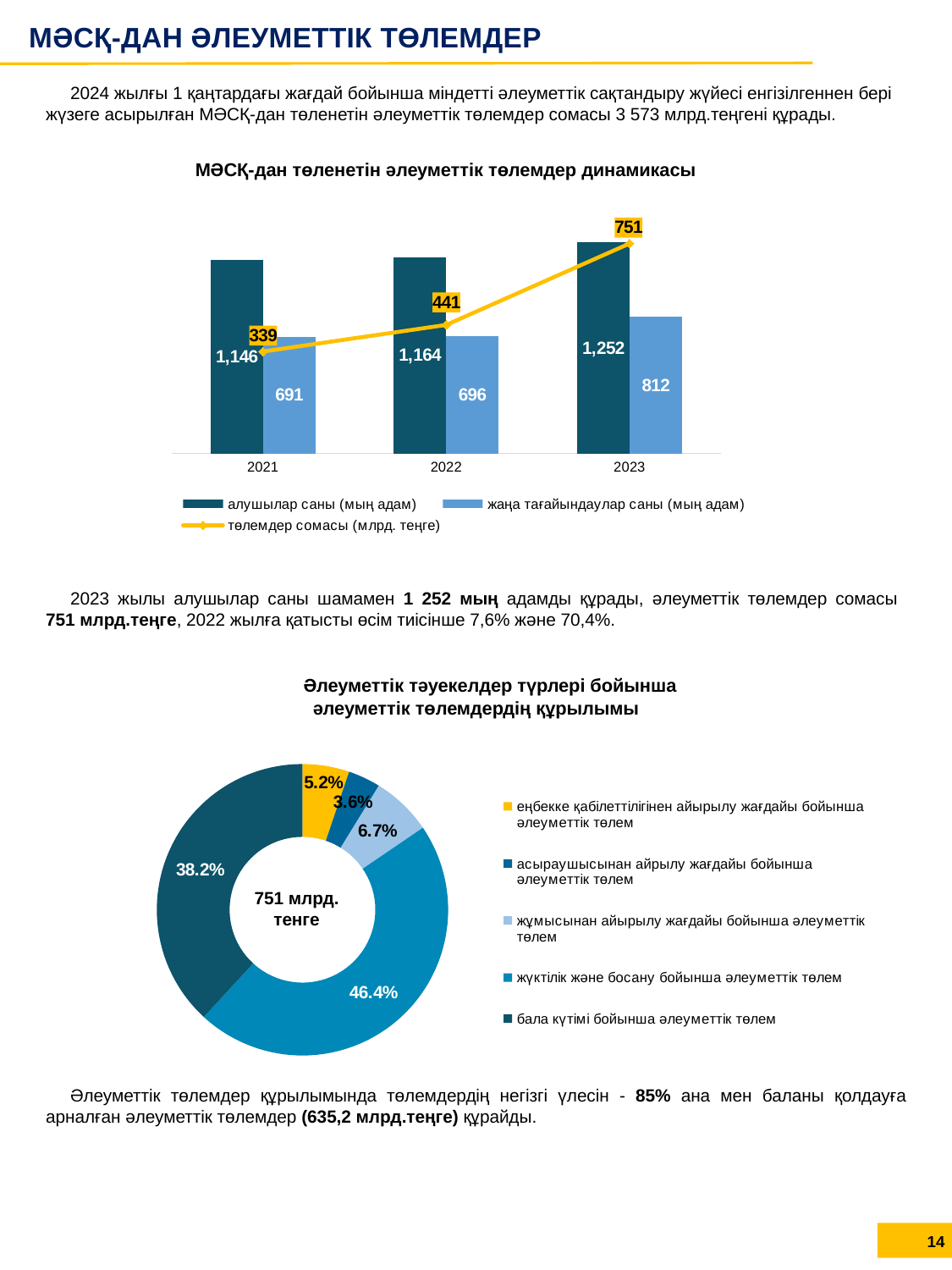
In the chart 'МӘСҚ-дан төленетін әлеуметтік төлемдер динамикасы', what is the value of 'алушылар саны (мың адам)' for 2023? 1,252 In the chart 'МӘСҚ-дан төленетін әлеуметтік төлемдер динамикасы', what is the value of 'жаңа тағайындаулар саны (мың адам)' for 2022? 696 In the chart 'Әлеуметтік тәуекелдер түрлері бойынша әлеуметтік төлемдердің құрылымы', what share is 'жүктілік және босану бойынша әлеуметтік төлем'? 46.4% In the chart 'МӘСҚ-дан төленетін әлеуметтік төлемдер динамикасы', does 'төлемдер сомасы (млрд. теңге)' rise or fall from 2021 to 2023? rise In the chart 'МӘСҚ-дан төленетін әлеуметтік төлемдер динамикасы', what is the value of 'төлемдер сомасы (млрд. теңге)' for 2021? 339 What total value is shown in the centre of the chart 'Әлеуметтік тәуекелдер түрлері бойынша әлеуметтік төлемдердің құрылымы'? 751 млрд. тенге What kind of chart is 'Әлеуметтік тәуекелдер түрлері бойынша әлеуметтік төлемдердің құрылымы'? doughnut chart In the chart 'Әлеуметтік тәуекелдер түрлері бойынша әлеуметтік төлемдердің құрылымы', which category has the smallest share? асыраушысынан айрылу жағдайы бойынша әлеуметтік төлем In the chart 'МӘСҚ-дан төленетін әлеуметтік төлемдер динамикасы', which year has the highest value for 'төлемдер сомасы (млрд. теңге)'? 2023 How many years are shown on the x axis of the chart 'МӘСҚ-дан төленетін әлеуметтік төлемдер динамикасы'? 3 How many series does the legend of the chart 'МӘСҚ-дан төленетін әлеуметтік төлемдер динамикасы' list? 3 In the chart 'МӘСҚ-дан төленетін әлеуметтік төлемдер динамикасы', what is the difference between 'төлемдер сомасы (млрд. теңге)' in 2023 and 2022? 310